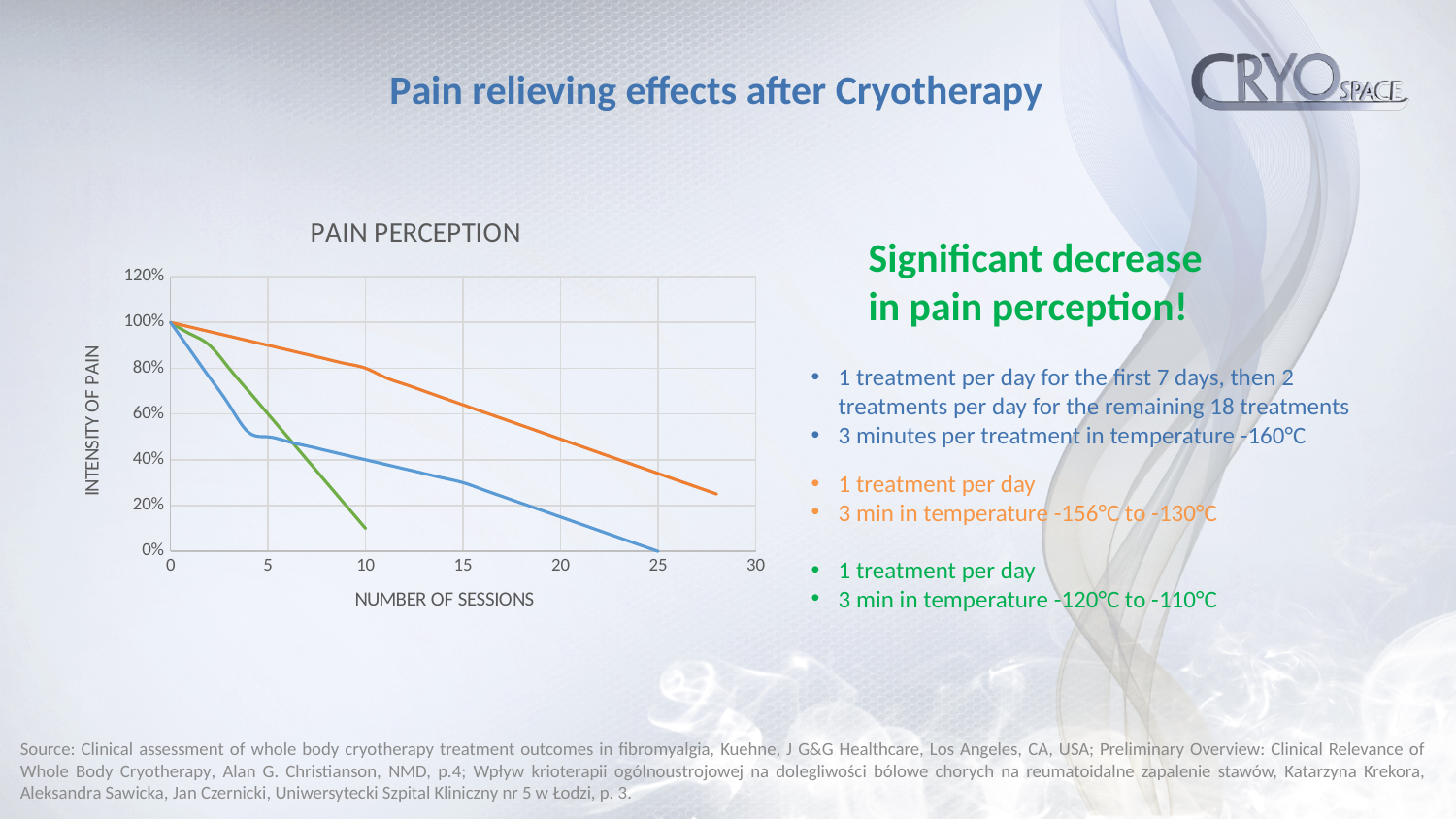
What is the intensity of pain for the blue line at 25 sessions? 0% At 10 sessions, which line shows a higher intensity of pain, the orange line or the blue line? orange line What kind of chart is shown on the slide? line chart Is the value of the blue line at 15 sessions greater or less than 40%? less Do the lines on the chart rise or fall as the number of sessions increases? fall What is the label of the x axis of the chart? NUMBER OF SESSIONS What is the intensity of pain at 0 sessions for all lines? 100% How many lines are plotted on the chart? 3 Which line extends to the highest number of sessions? orange line Is the value of the green line at 10 sessions greater or less than 20%? less Is the value of the orange line at 10 sessions greater or less than 60%? greater What is the title of the chart? PAIN PERCEPTION